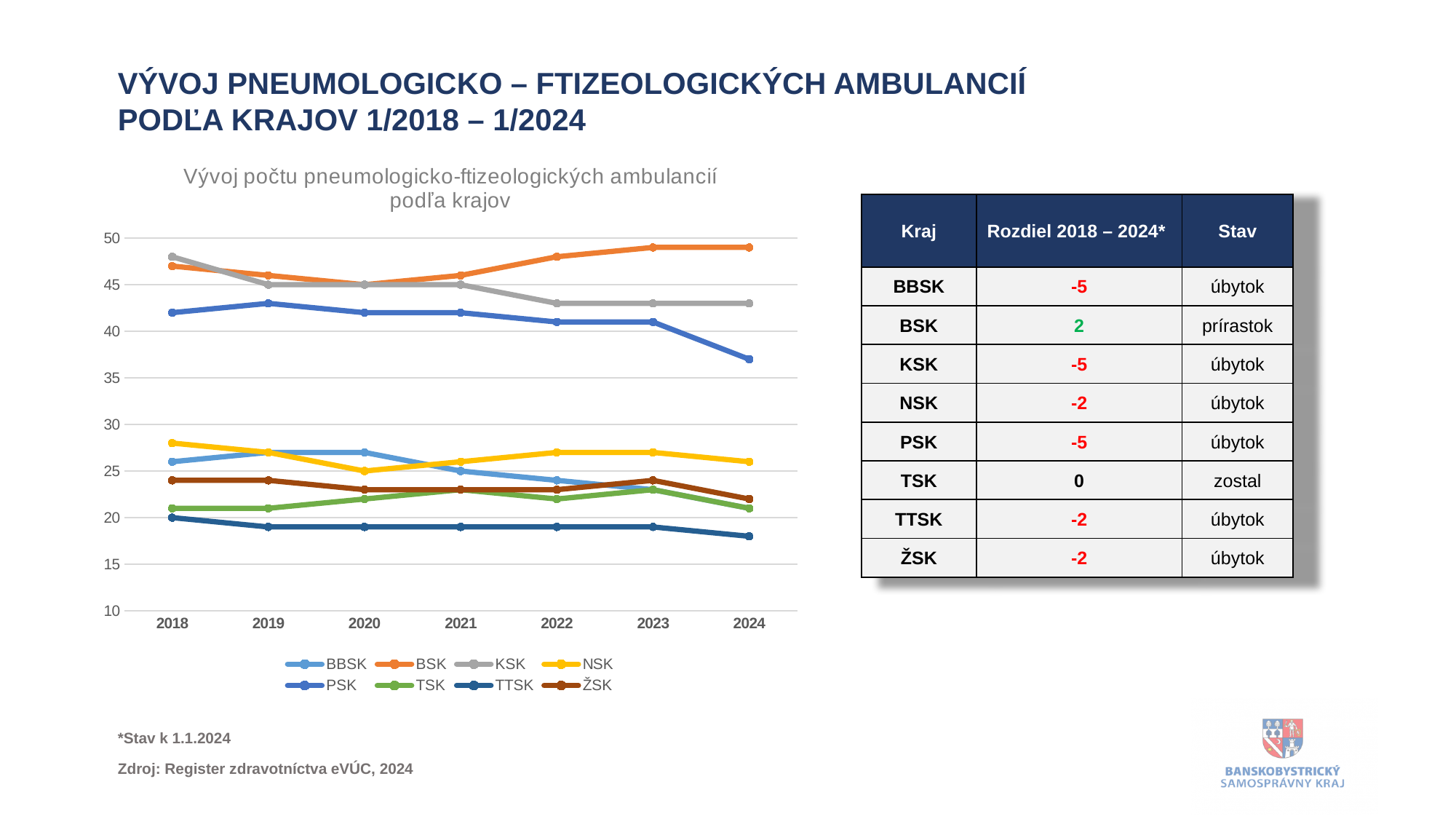
What is the title of the chart? Vývoj počtu pneumologicko-ftizeologických ambulancií podľa krajov Which region has the highest value in 2024 in the chart? BSK Does the value for PSK rise or fall from 2019 to 2024? fall How many years are plotted along the x axis of the chart? 7 How many series does the chart legend list? 8 Which is larger in 2024, the value for BSK or the value for KSK? BSK Is the value for NSK in 2018 greater or less than 25? greater Is the value for PSK in 2024 greater or less than 40? less Is the value for BSK in 2024 greater or less than 45? greater Which region has the lowest value in 2024 in the chart? TTSK What kind of chart is shown on the slide? line chart Which is larger in 2018, the value for PSK or the value for NSK? PSK